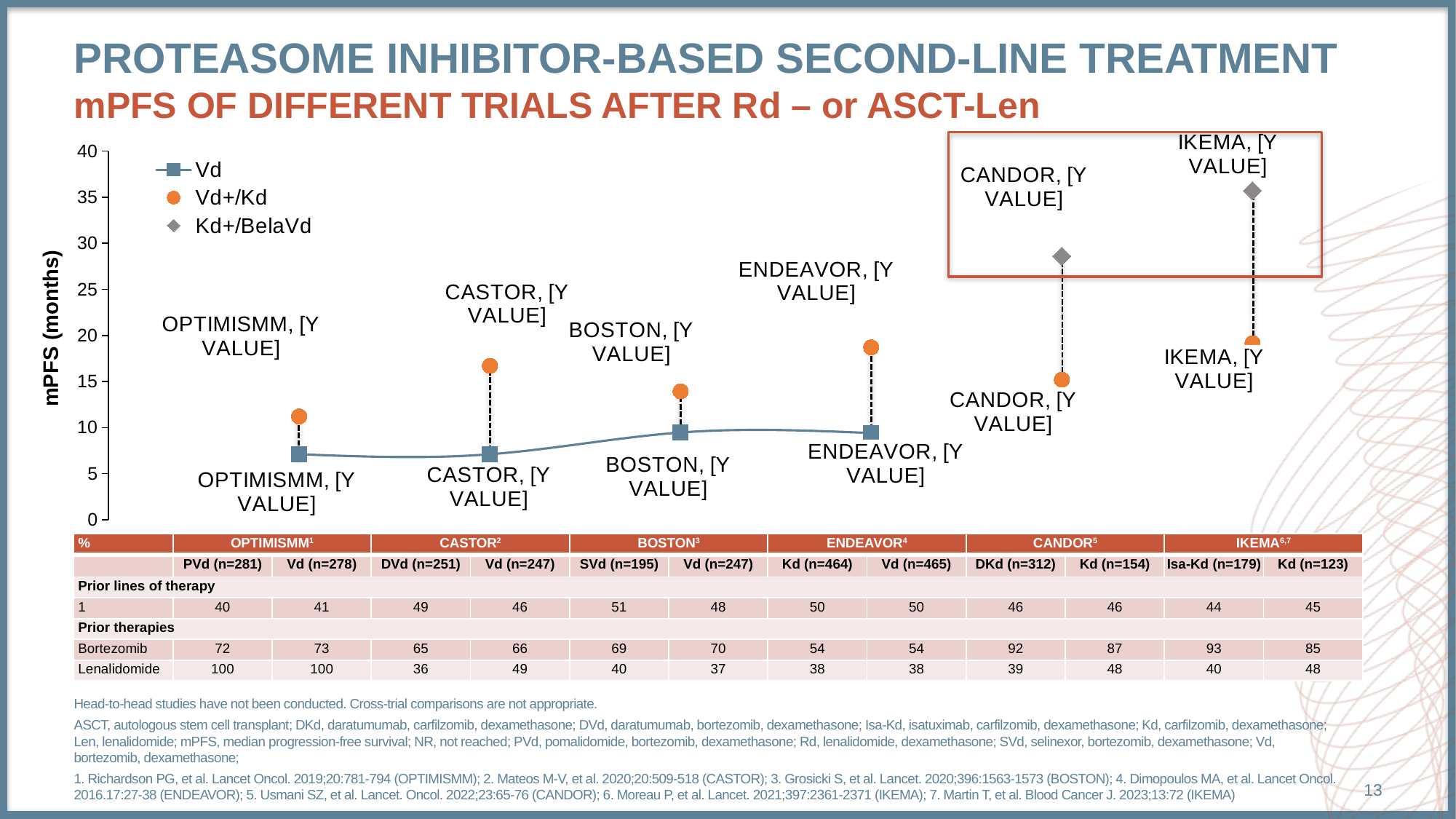
What are the three series named in the chart legend? Vd, Vd+/Kd, Kd+/BelaVd Which trial has the lowest Vd+/Kd value? OPTIMISMM How many trials are plotted along the x axis of the chart? 6 How many series does the chart legend list? 3 Is the Vd value for OPTIMISMM greater or less than 10? less Which trial has the higher Kd+/BelaVd value, CANDOR or IKEMA? IKEMA Is the Vd+/Kd value for CASTOR greater or less than 15? greater What is the label of the chart's y axis? mPFS (months) Is the Kd+/BelaVd value for IKEMA greater or less than 30? greater Which trial has the higher Vd+/Kd value, OPTIMISMM or ENDEAVOR? ENDEAVOR